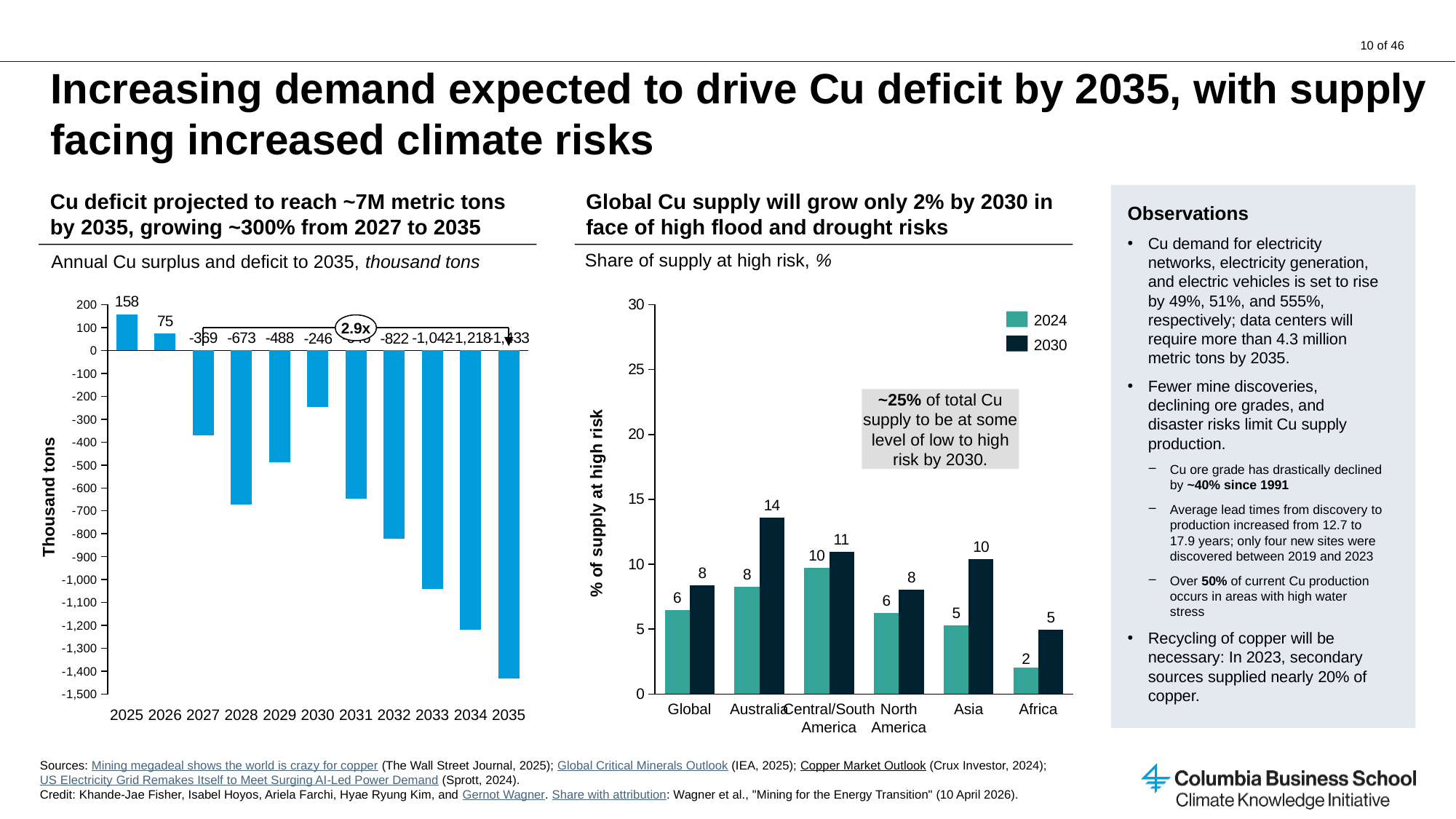
In the right chart (Share of supply at high risk), how many series does the legend list? 2 In the left chart (Annual Cu surplus and deficit to 2035), what is the value for 2025? 158 In the left chart (Annual Cu surplus and deficit to 2035), is the value for 2035 greater or less than -1,000? less In the left chart (Annual Cu surplus and deficit to 2035), what is the value for 2028? -673 In the right chart (Share of supply at high risk), what is the 2024 value for Africa? 2 In the right chart (Share of supply at high risk), which region has the highest 2030 value? Australia In the left chart (Annual Cu surplus and deficit to 2035), which year has the highest value? 2025 In the left chart (Annual Cu surplus and deficit to 2035), how many years are plotted? 11 In the right chart (Share of supply at high risk), what is the difference between the 2030 and 2024 values for Asia? 5 In the right chart (Share of supply at high risk), what is the 2030 value for Australia? 14 In the left chart (Annual Cu surplus and deficit to 2035), which year has the lowest value? 2035 In the left chart (Annual Cu surplus and deficit to 2035), what is the difference between the values for 2034 and 2033? 176